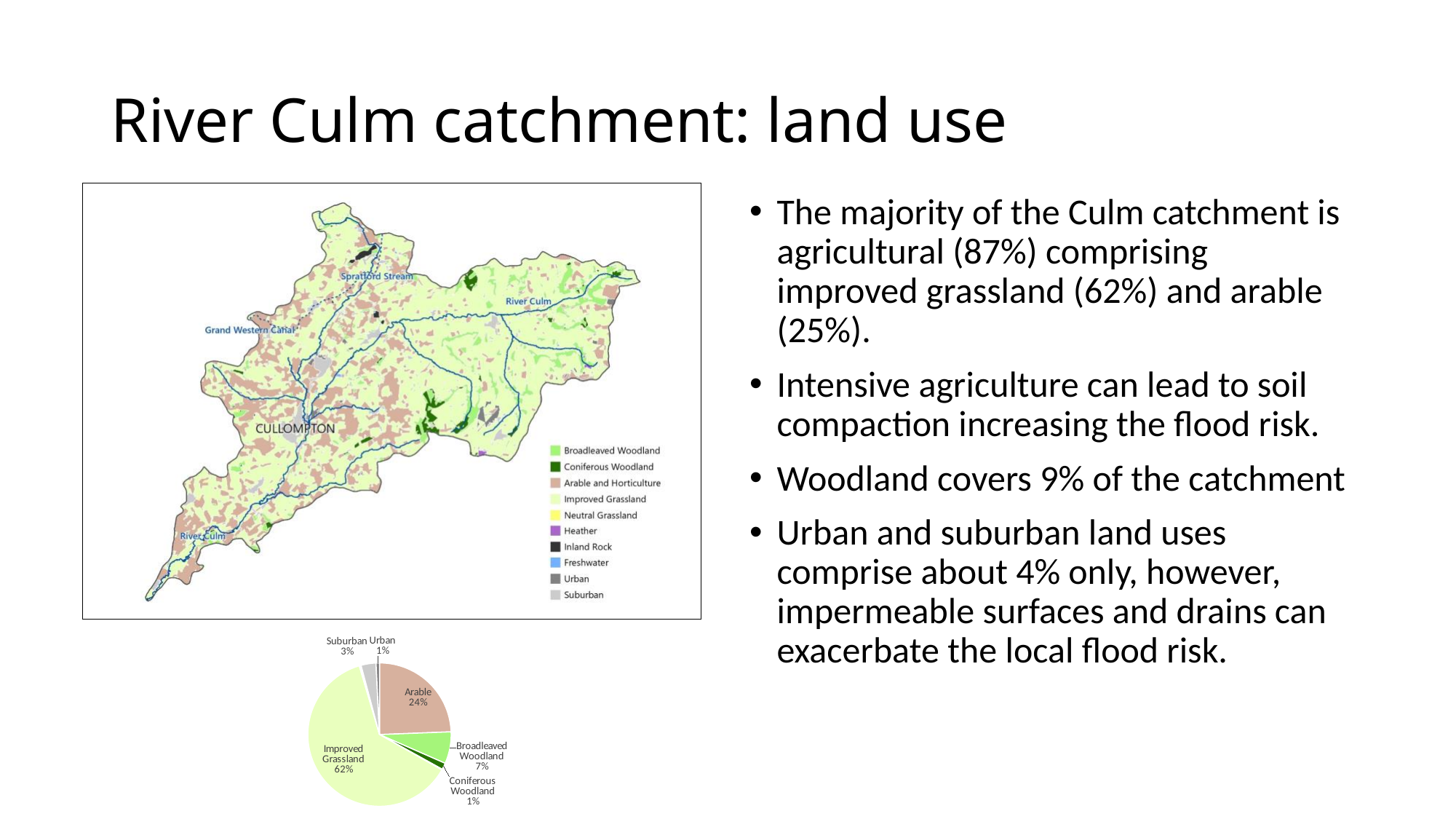
In the pie chart, what is the combined share of Broadleaved Woodland and Coniferous Woodland? 8% In the pie chart, what percentage is Coniferous Woodland? 1% Which slice of the pie chart is the largest? Improved Grassland In the pie chart, what share is Broadleaved Woodland? 7% In the pie chart, which is larger: Arable or Urban? Arable In the pie chart, what percentage is labelled for Arable? 24% In the pie chart, what is the difference in percentage points between Improved Grassland and Arable? 38 In the pie chart, what percentage is Suburban? 3% What type of chart is shown at the bottom left of the slide? pie chart In the pie chart, what share of land use is Improved Grassland? 62% In the pie chart, which is larger: Broadleaved Woodland or Suburban? Broadleaved Woodland